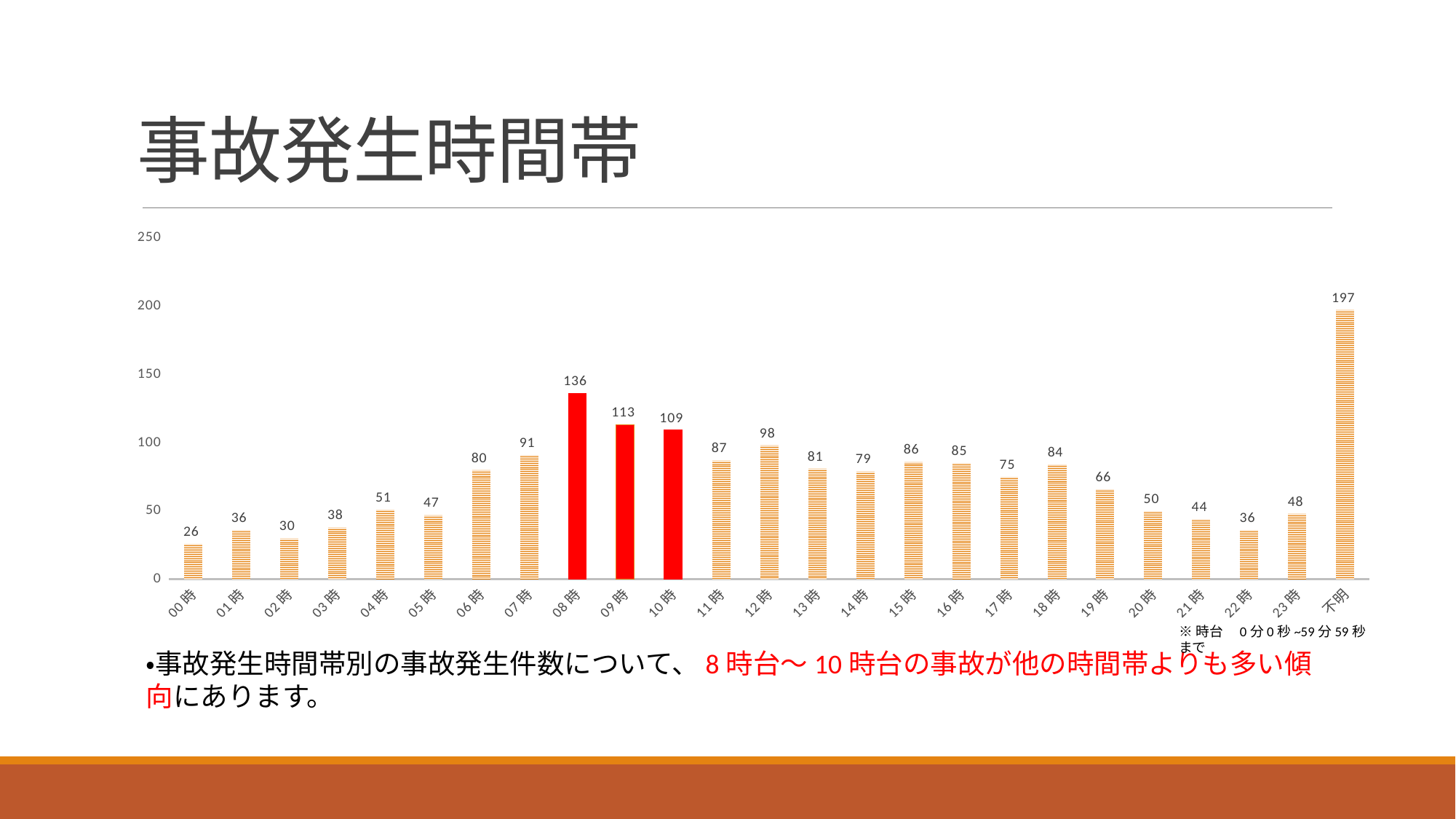
Which bars are coloured solid red? 08時, 09時, 10時 Which category has the highest value? 不明 What is the value for 不明? 197 Which is larger, the value for 09時 or the value for 11時? 09時 Is the value for 不明 greater or less than 150? greater What is the value for 08時? 136 What is the value for 12時? 98 Which category has the lowest value? 00時 What kind of chart is shown on the slide? bar chart Do the values rise or fall from 00時 to 04時? rise How many categories are shown on the x axis? 25 What is the difference between the values for 08時 and 10時? 27